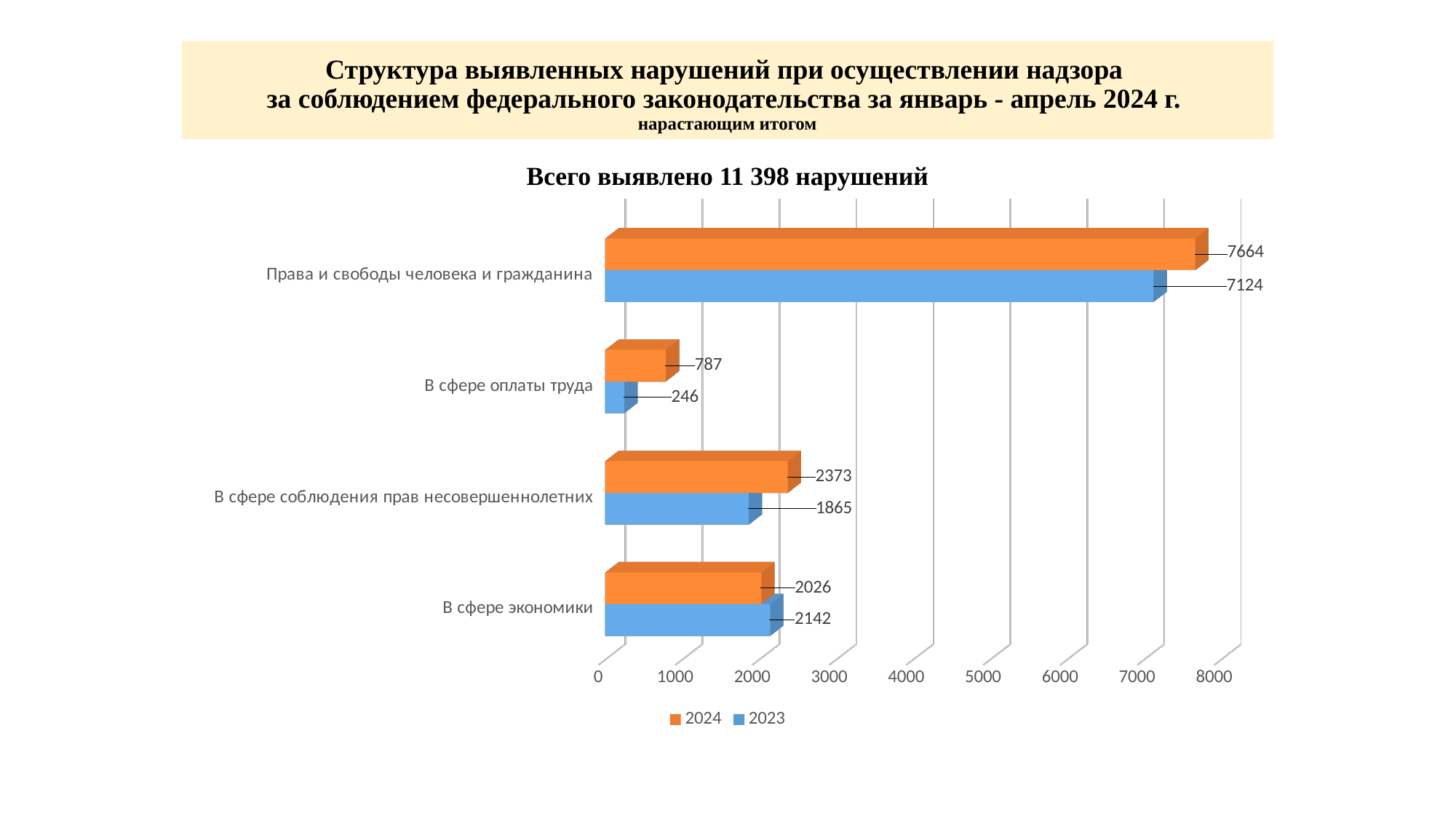
What is the 2023 value for 'В сфере оплаты труда'? 246 How many series does the legend list? 2 What is the 2024 value for 'В сфере соблюдения прав несовершеннолетних'? 2373 How many categories are shown on the chart? 4 What is the 2023 value for 'В сфере экономики'? 2142 Which category has the highest 2024 value? Права и свободы человека и гражданина What is the 2024 value for 'Права и свободы человека и гражданина'? 7664 What is the difference between the 2024 and 2023 values for 'В сфере оплаты труда'? 541 Which category has the lowest 2023 value? В сфере оплаты труда What is the difference between the 2024 and 2023 values for 'Права и свободы человека и гражданина'? 540 For 'В сфере экономики', which year has the larger value, 2024 or 2023? 2023 What kind of chart is shown on the slide? Bar chart